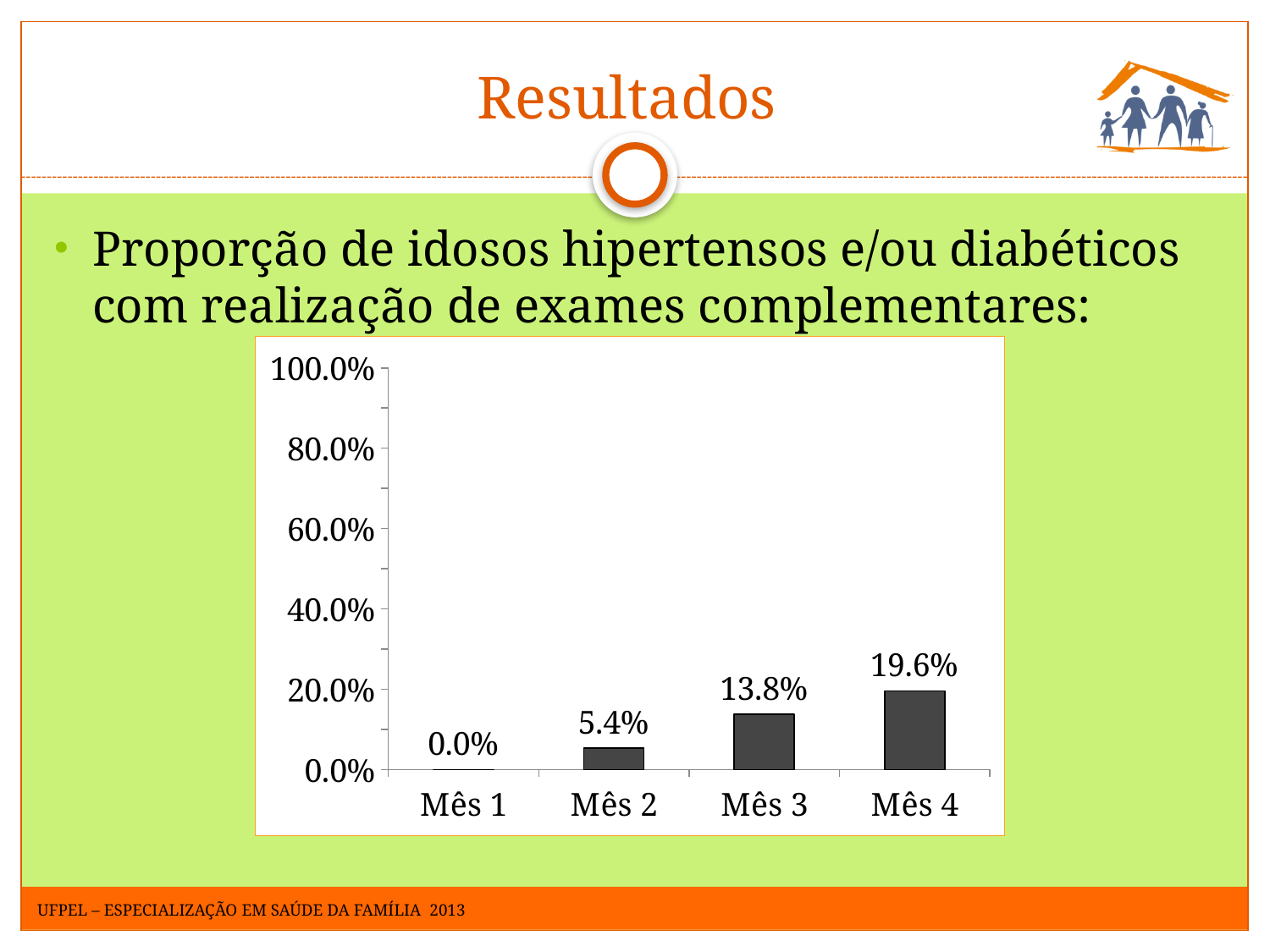
Do the values rise or fall from Mês 1 to Mês 4? rise What is the value for Mês 2? 5.4% What is the value for Mês 3? 13.8% Is the value for Mês 4 greater or less than 20.0%? less What is the difference between the values for Mês 4 and Mês 3? 5.8% What kind of chart is shown on the slide? bar chart What is the value for Mês 1? 0.0% What is the difference between the values for Mês 3 and Mês 2? 8.4% How many months are shown on the x axis? 4 Which month has the lowest value? Mês 1 Which is larger, the value for Mês 2 or the value for Mês 4? Mês 4 Which month has the highest value? Mês 4